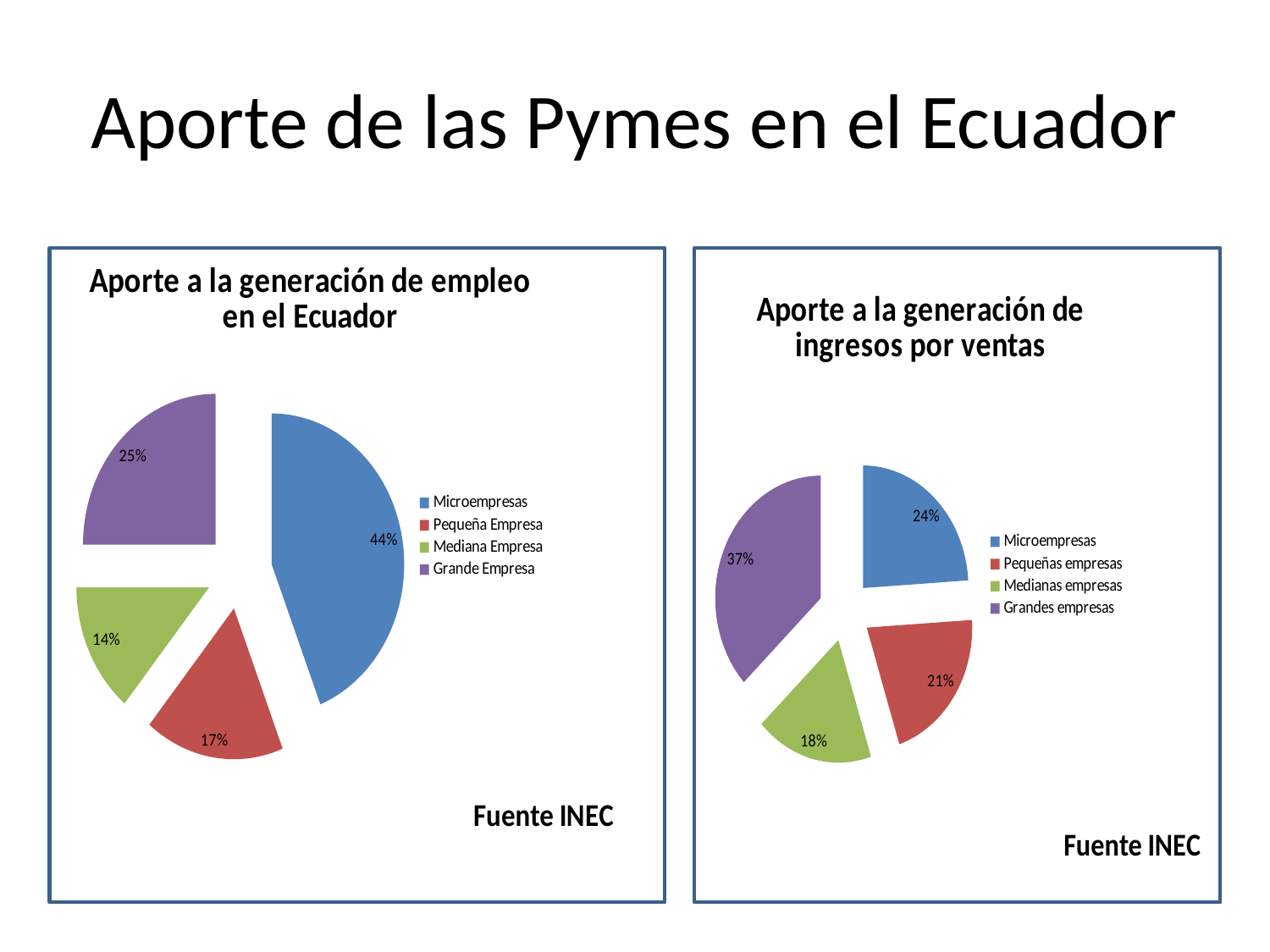
In the chart 'Aporte a la generación de ingresos por ventas', what share do Pequeñas empresas have? 21% In the chart 'Aporte a la generación de empleo en el Ecuador', how many categories does the legend list? 4 In the chart 'Aporte a la generación de empleo en el Ecuador', what is the difference between the shares of Pequeña Empresa and Mediana Empresa? 3% In the chart 'Aporte a la generación de empleo en el Ecuador', what colour is the Microempresas slice? Blue In the chart 'Aporte a la generación de ingresos por ventas', which is larger: the share of Microempresas or the share of Medianas empresas? Microempresas What type of chart is used in the chart 'Aporte a la generación de ingresos por ventas'? Pie chart In the chart 'Aporte a la generación de empleo en el Ecuador', which category has the smallest share? Mediana Empresa In the chart 'Aporte a la generación de empleo en el Ecuador', what share does Grande Empresa have? 25% In the chart 'Aporte a la generación de empleo en el Ecuador', what share do Microempresas have? 44% In the chart 'Aporte a la generación de ingresos por ventas', which category has the largest share? Grandes empresas In the chart 'Aporte a la generación de ingresos por ventas', what is the difference between the shares of Grandes empresas and Microempresas? 13% In the chart 'Aporte a la generación de ingresos por ventas', what share do Grandes empresas have? 37%